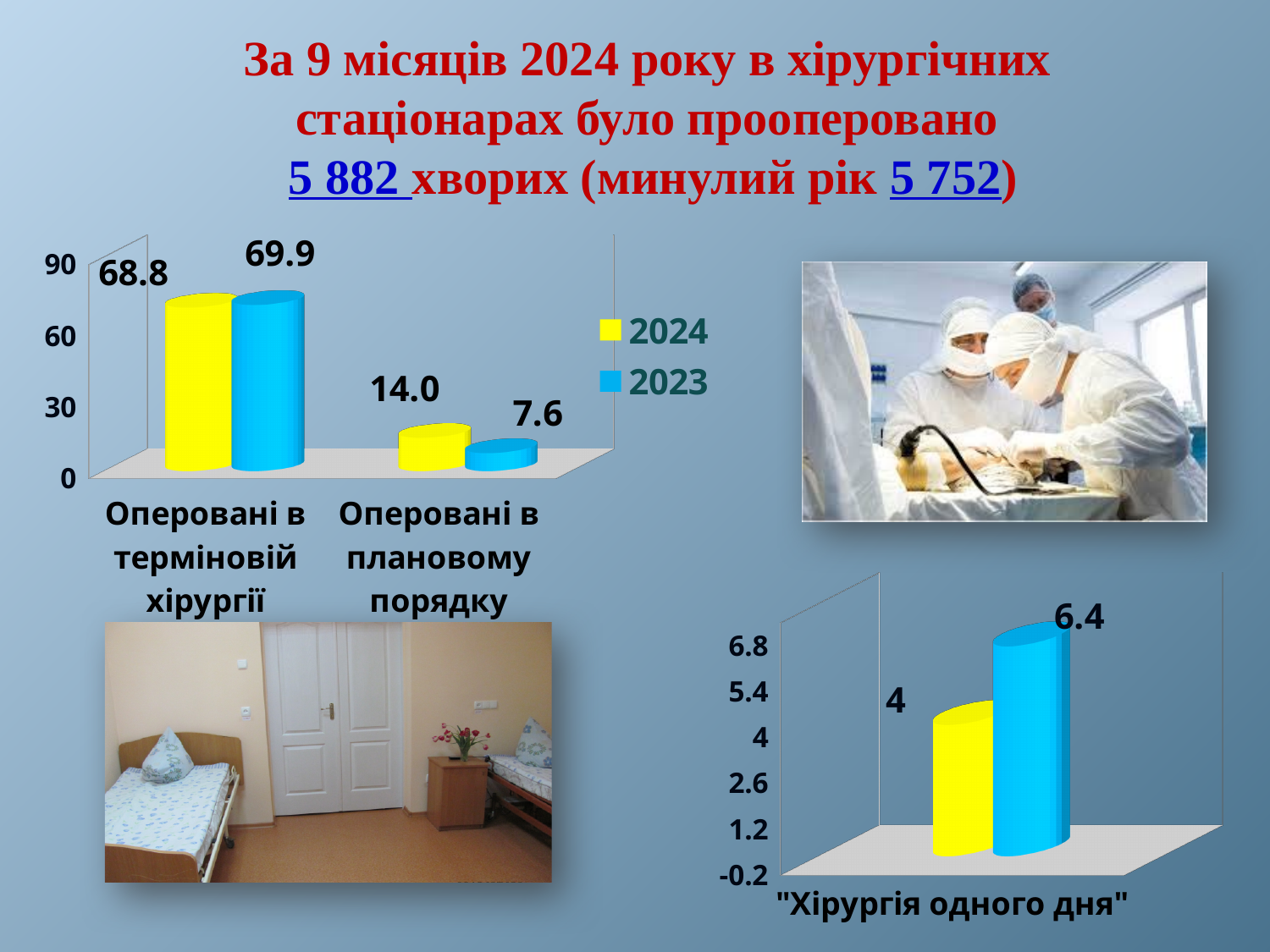
In the left chart, what is the 2023 value for "Оперовані в терміновій хірургії"? 69.9 In the left chart, what is the 2023 value for "Оперовані в плановому порядку"? 7.6 What kind of chart is the left chart? Bar chart In the left chart, what is the 2024 value for "Оперовані в плановому порядку"? 14.0 In the left chart, how many categories are shown on the x axis? 2 In the bottom-right chart "Хірургія одного дня", what is the difference between the blue bar and the yellow bar? 2.4 In the left chart, what is the 2024 value for "Оперовані в терміновій хірургії"? 68.8 In the bottom-right chart "Хірургія одного дня", what is the value of the blue bar? 6.4 In the left chart, which year has the larger value for "Оперовані в терміновій хірургії"? 2023 In the left chart, how many series does the legend list? 2 In the left chart, what is the difference between the 2024 and 2023 values for "Оперовані в плановому порядку"? 6.4 In the bottom-right chart "Хірургія одного дня", what is the value of the yellow bar? 4